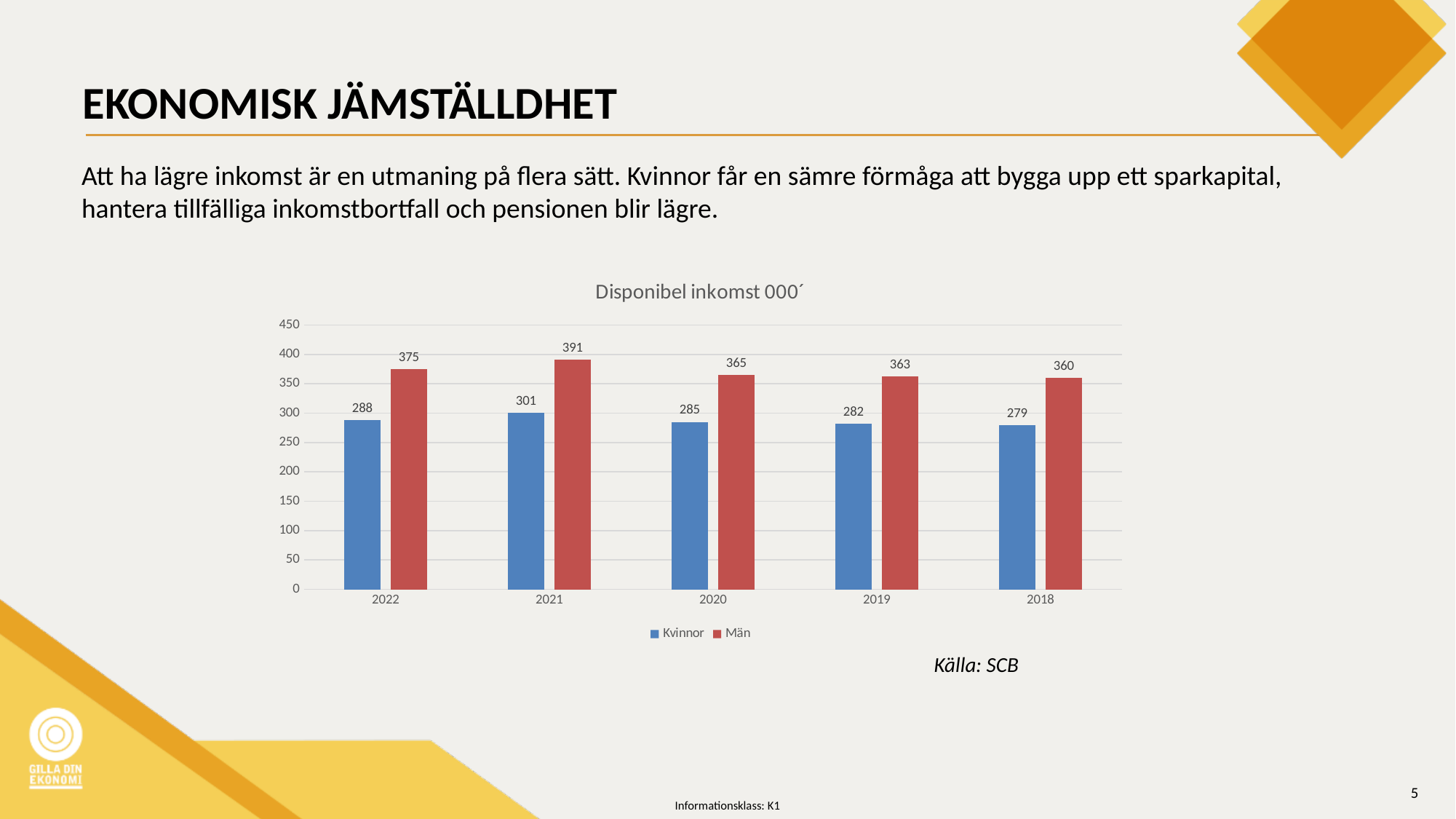
Which is larger in 2019, the value for Kvinnor or the value for Män? Män What is the value for Kvinnor in 2022? 288 What is the title of the chart? Disponibel inkomst 000´ In which year is the value for Män highest? 2021 What is the value for Kvinnor in 2018? 279 What kind of chart is shown on the slide? bar chart What is the value for Män in 2021? 391 Is the value for Män in 2022 greater or less than 350? greater How many series does the legend list? 2 How many years are shown on the x axis? 5 In which year is the value for Kvinnor lowest? 2018 What is the difference between Män and Kvinnor in 2020? 80